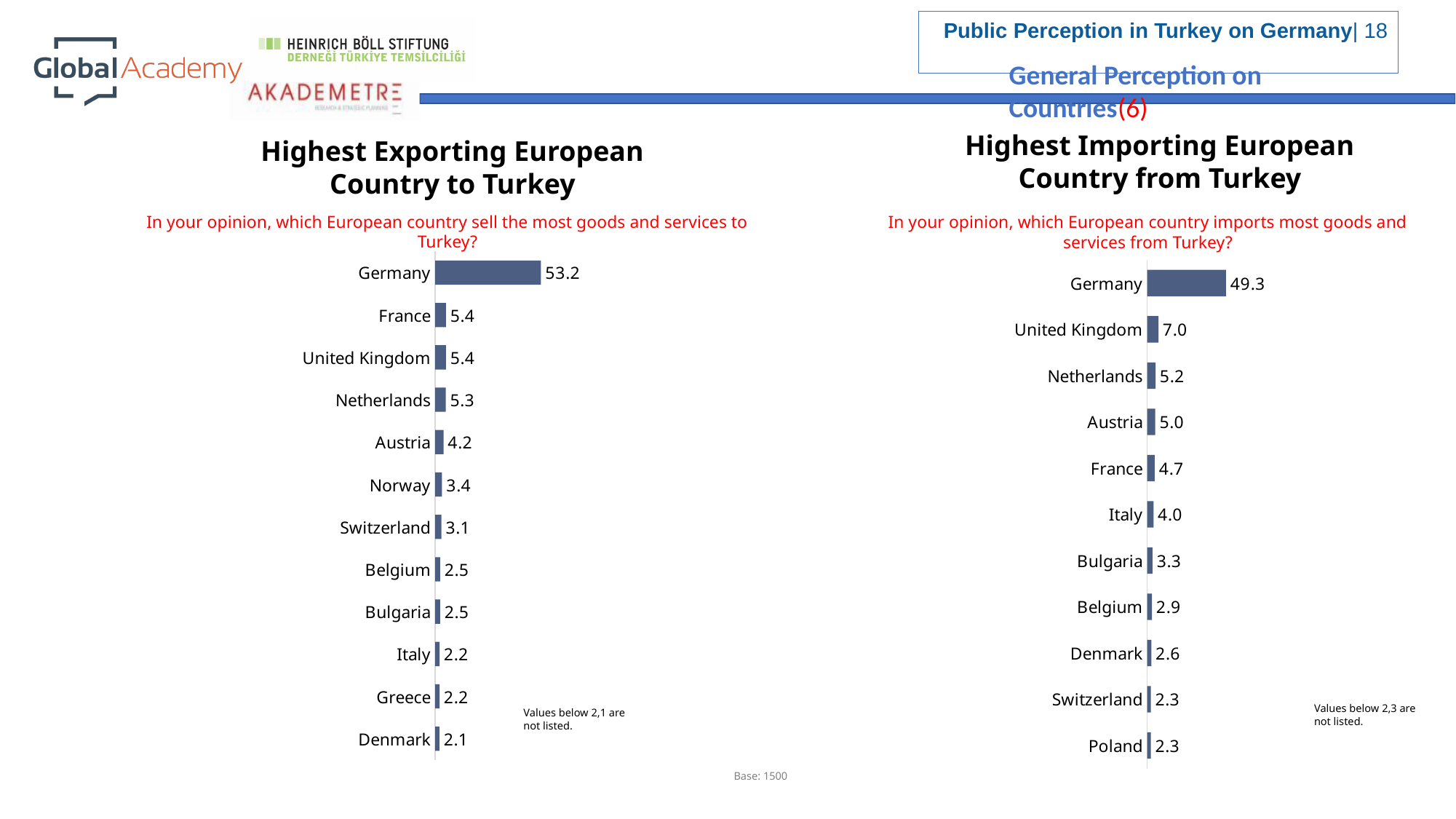
In the 'Highest Exporting European Country to Turkey' chart, what is the value for Germany? 53.2 In the 'Highest Importing European Country from Turkey' chart, what is the value for the United Kingdom? 7.0 What type of chart is the 'Highest Importing European Country from Turkey' chart? Bar chart In the 'Highest Exporting European Country to Turkey' chart, what is the difference between the values for Germany and France? 47.8 In the 'Highest Exporting European Country to Turkey' chart, what is the value for Denmark? 2.1 In the 'Highest Importing European Country from Turkey' chart, which country has the lowest value? Switzerland and Poland (2.3) How many countries are listed in the 'Highest Importing European Country from Turkey' chart? 11 How many countries are listed in the 'Highest Exporting European Country to Turkey' chart? 12 In the 'Highest Importing European Country from Turkey' chart, what is the difference between the values for Germany and the United Kingdom? 42.3 In the 'Highest Exporting European Country to Turkey' chart, which has a larger value, Norway or Switzerland? Norway In the 'Highest Importing European Country from Turkey' chart, which has a larger value, Austria or France? Austria In the 'Highest Exporting European Country to Turkey' chart, which country has the highest value? Germany